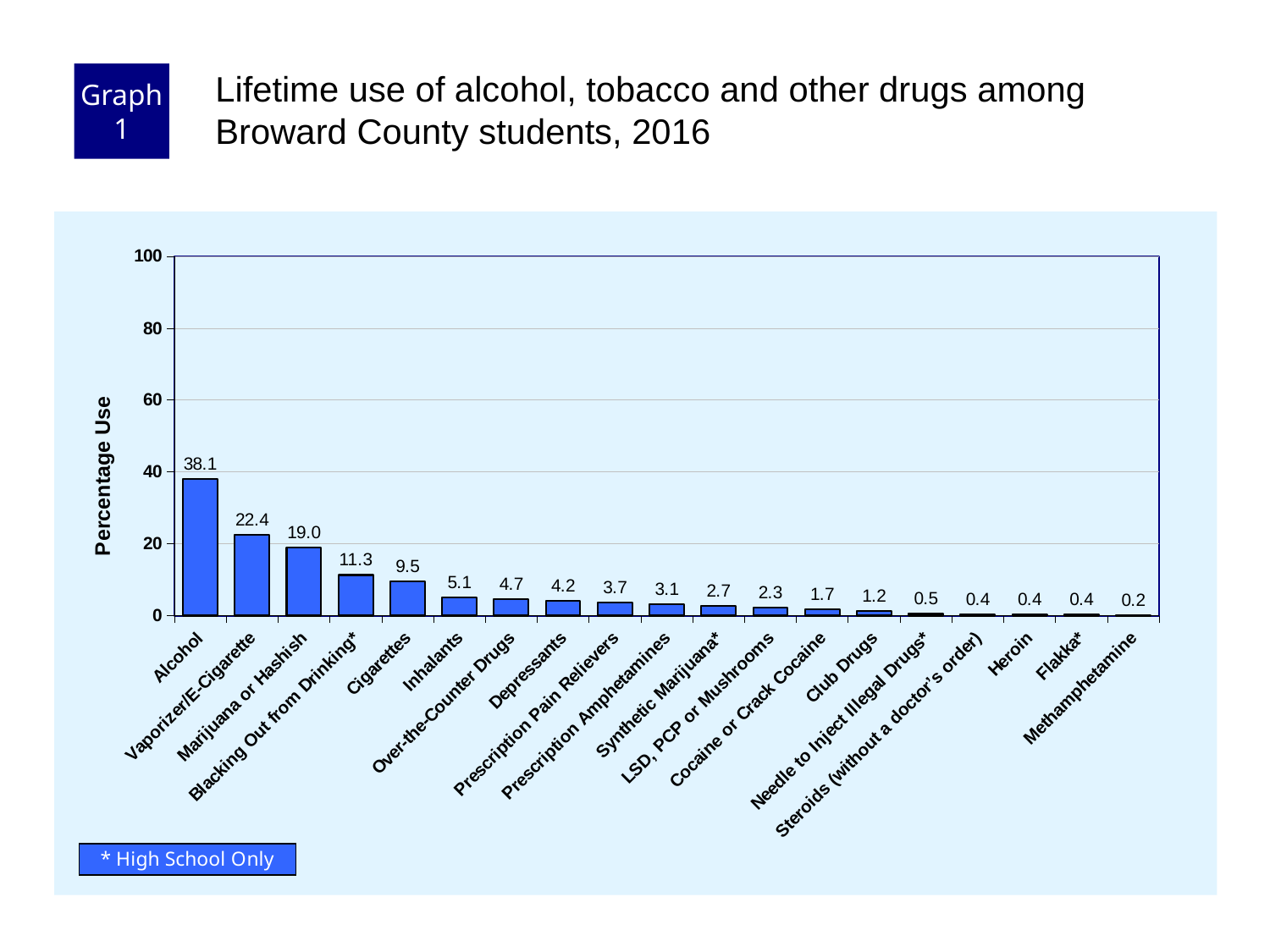
How many categories are shown on the x axis? 19 What is the label of the y axis? Percentage Use Which category has the highest percentage use? Alcohol Which has a higher percentage use, Blacking Out from Drinking* or Cigarettes? Blacking Out from Drinking* Is the value for Vaporizer/E-Cigarette greater or less than 20? greater Which category has the lowest percentage use? Methamphetamine What is the percentage use for Cigarettes? 9.5 What is the difference in percentage use between Alcohol and Marijuana or Hashish? 19.1 What is the percentage use for Vaporizer/E-Cigarette? 22.4 What kind of chart is shown on the slide? Bar chart What is the percentage use for Alcohol? 38.1 What is the percentage use for Inhalants? 5.1